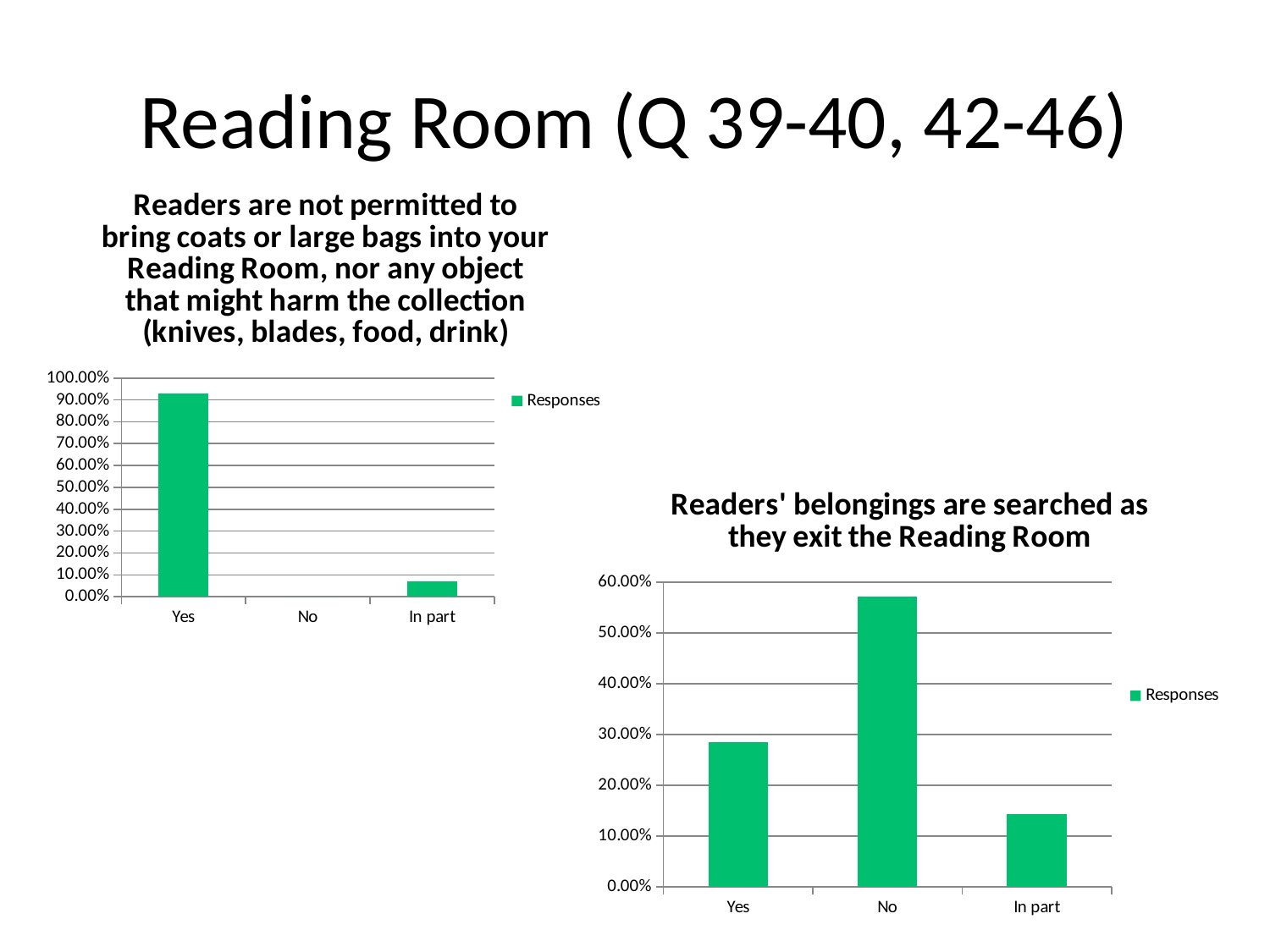
In the left chart about coats and large bags, which category has the highest value? Yes In the left chart about coats and large bags, is the value for Yes greater or less than 90.00%? greater In the chart titled 'Readers' belongings are searched as they exit the Reading Room', which is larger, the value for Yes or the value for In part? Yes What kind of chart is the left chart titled 'Readers are not permitted to bring coats or large bags into your Reading Room...'? bar chart How many series does the legend list in the chart titled 'Readers' belongings are searched as they exit the Reading Room'? 1 In the chart titled 'Readers' belongings are searched as they exit the Reading Room', is the value for No greater or less than 50.00%? greater In the chart titled 'Readers' belongings are searched as they exit the Reading Room', which category has the lowest value? In part In the left chart about coats and large bags, is the value for In part greater or less than 10.00%? less In the left chart about coats and large bags, which category has the lowest value? No In the chart titled 'Readers' belongings are searched as they exit the Reading Room', which category has the highest value? No How many categories are shown on the x axis of the left chart about coats and large bags? 3